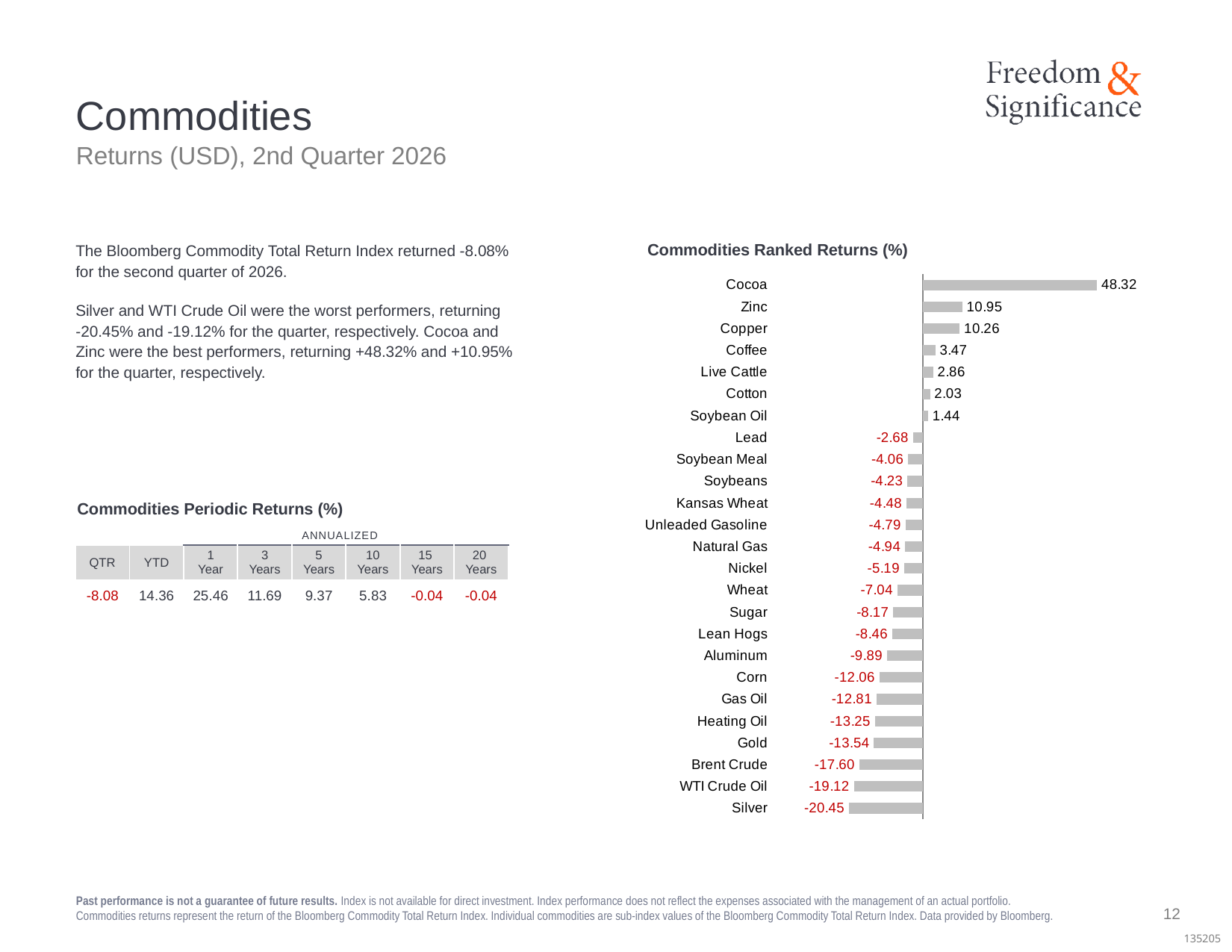
What is the value for Copper in the Commodities Ranked Returns (%) chart? 10.26 What is the value for Silver in the Commodities Ranked Returns (%) chart? -20.45 Which commodity has the lowest return in the Commodities Ranked Returns (%) chart? Silver What is the difference between the values for Cocoa and Silver in the Commodities Ranked Returns (%) chart? 68.77 Which commodity has the highest return in the Commodities Ranked Returns (%) chart? Cocoa What is the title of the chart on the slide? Commodities Ranked Returns (%) How many commodities are shown in the Commodities Ranked Returns (%) chart? 25 What is the difference between the values for Zinc and Copper in the Commodities Ranked Returns (%) chart? 0.69 What is the value for Cocoa in the Commodities Ranked Returns (%) chart? 48.32 What is the value for Natural Gas in the Commodities Ranked Returns (%) chart? -4.94 In the Commodities Ranked Returns (%) chart, which is larger, the value for Gold or the value for Corn? Corn What kind of chart is the Commodities Ranked Returns (%) chart? Bar chart